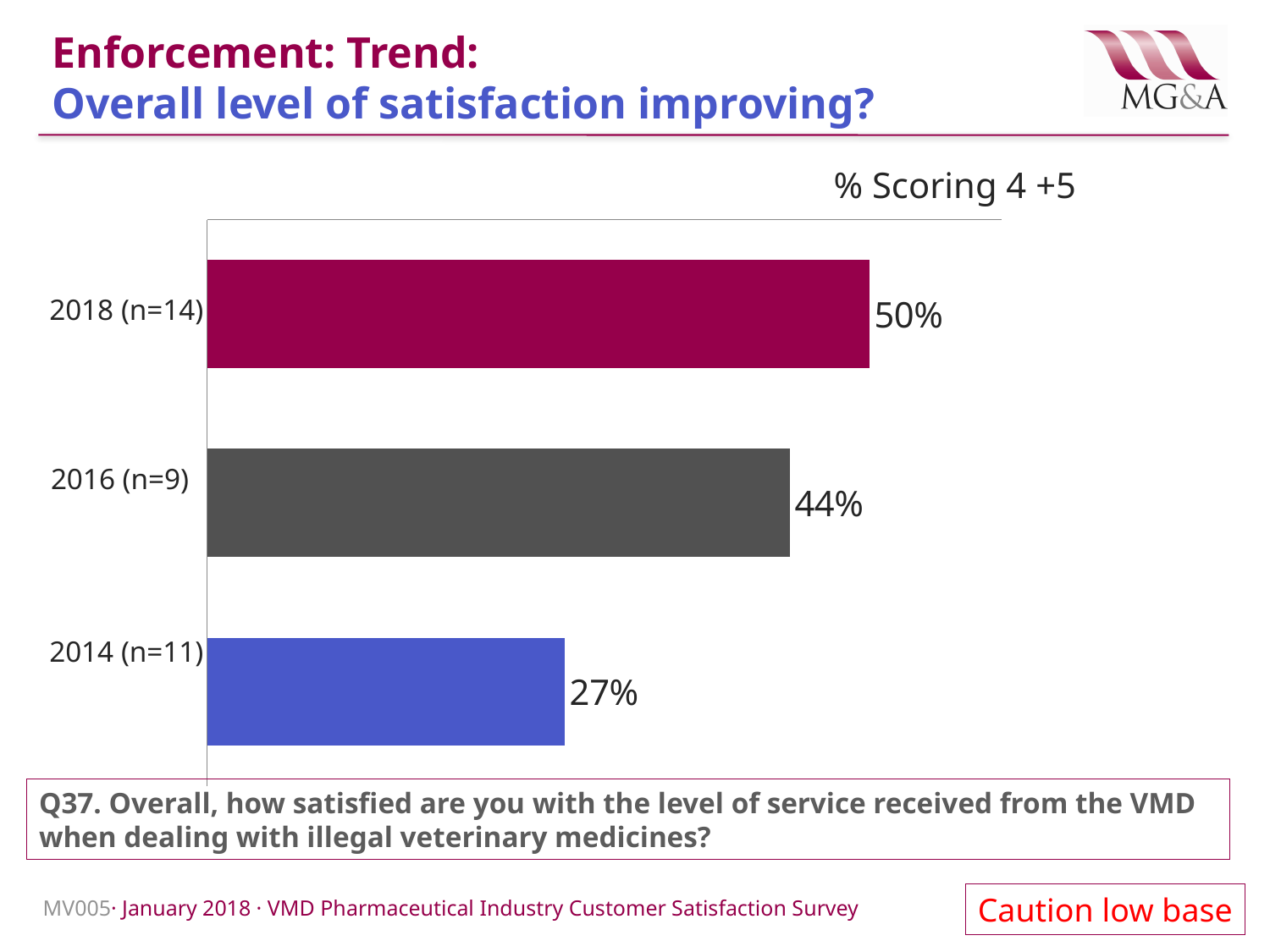
What is the value for 2018 (n=14)? 50% Do the values rise or fall from 2014 to 2018? Rise What kind of chart is shown on the slide? Bar chart Which is larger, the value for 2016 (n=9) or the value for 2014 (n=11)? 2016 (n=9) What label appears above the chart describing what is plotted? % Scoring 4 +5 Which year has the lowest % scoring 4+5? 2014 (n=11) What is the difference between the 2018 and 2014 values? 23% What is the value for 2014 (n=11)? 27% What is the value for 2016 (n=9)? 44% How many years are shown in the chart? 3 Which year has the highest % scoring 4+5? 2018 (n=14) What is the difference between the 2018 and 2016 values? 6%